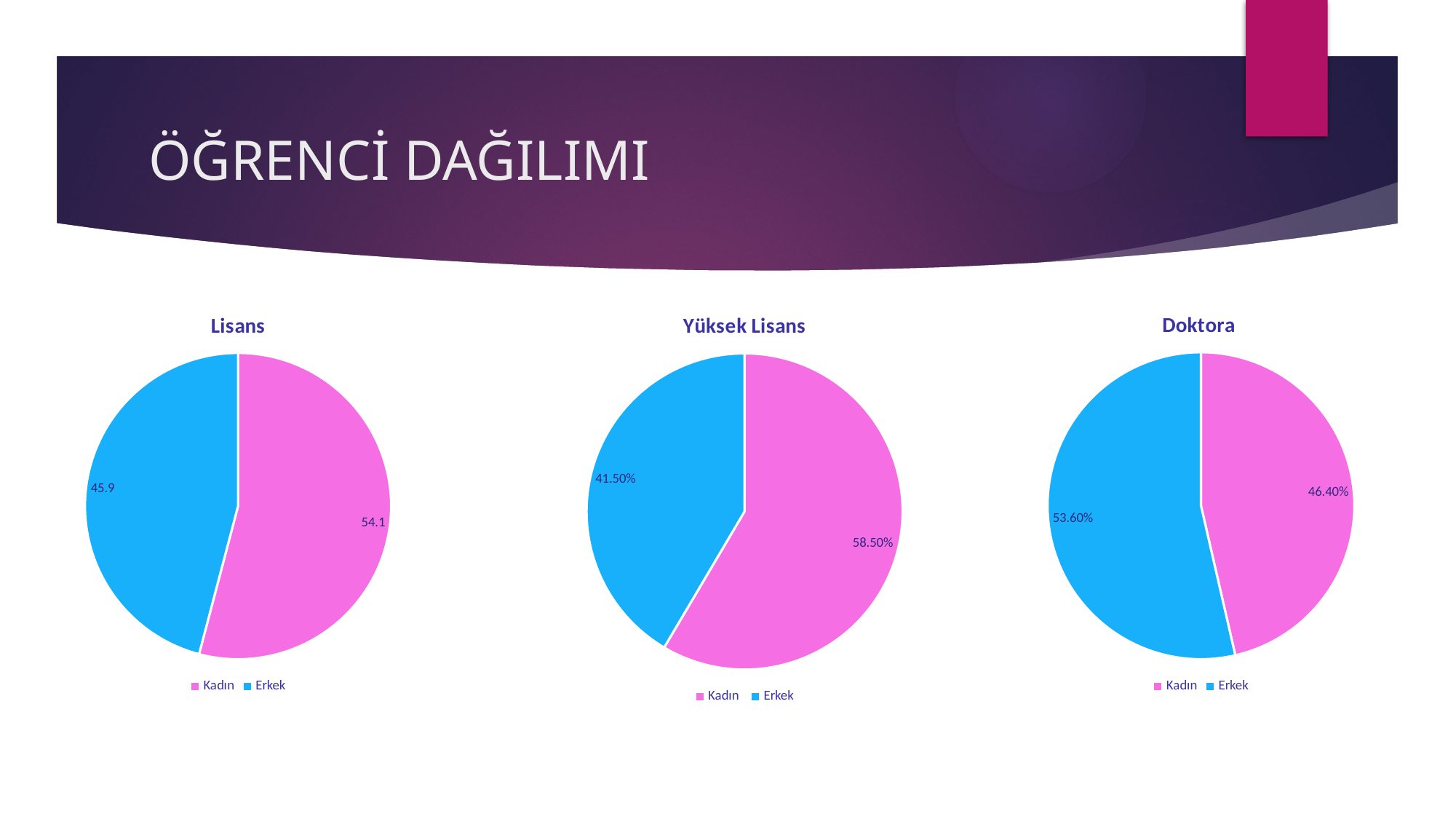
In the Yüksek Lisans chart, what is the value for Erkek? 41.50% In the Doktora chart, which slice is larger, Kadın or Erkek? Erkek What kind of chart is the Doktora chart? Pie chart In the Doktora chart, what is the value for Kadın? 46.40% In the Lisans chart, what is the value for Erkek? 45.9 In the Yüksek Lisans chart, what is the difference between the Kadın and Erkek values? 17.00% In the Lisans chart, what is the value for Kadın? 54.1 In the Yüksek Lisans chart, what is the value for Kadın? 58.50% In the Yüksek Lisans chart, which slice is the largest? Kadın In the Lisans chart, what is the difference between the Kadın and Erkek values? 8.2 How many slices does the Lisans chart have? 2 In the Doktora chart, what is the value for Erkek? 53.60%